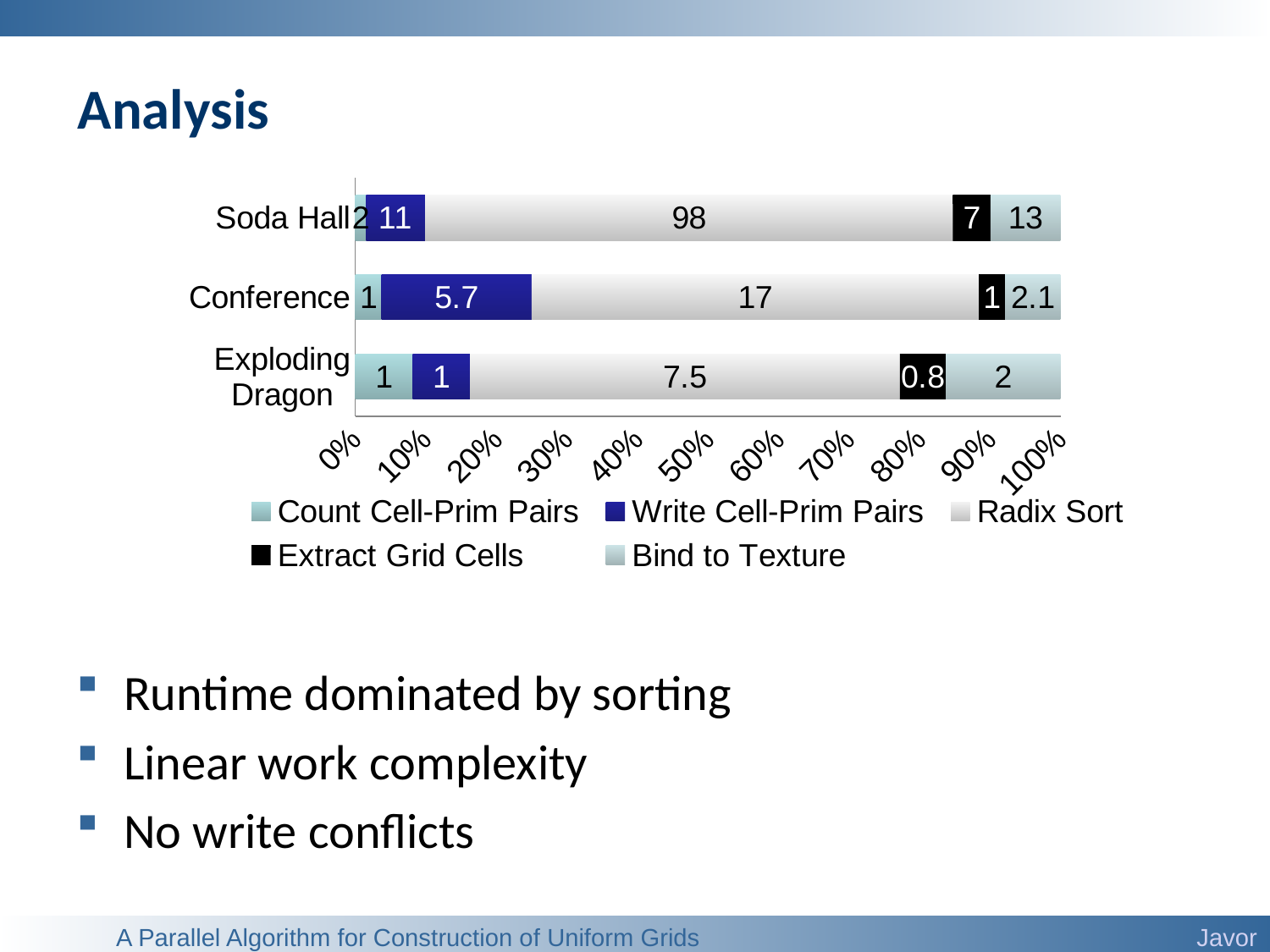
Which is larger, the Write Cell-Prim Pairs value for Soda Hall or for Conference? Soda Hall Which category has the highest Radix Sort value? Soda Hall What is the difference between the Radix Sort values for Soda Hall and Conference? 81 How many categories are shown on the chart? 3 What is the Radix Sort value for Soda Hall? 98 What is the Bind to Texture value for Soda Hall? 13 What is the total of all segments in the Exploding Dragon bar? 12.3 What is the Write Cell-Prim Pairs value for Conference? 5.7 What kind of chart is shown on the slide? Stacked bar chart Which category has the lowest Radix Sort value? Exploding Dragon How many series does the legend list? 5 What is the Extract Grid Cells value for Exploding Dragon? 0.8